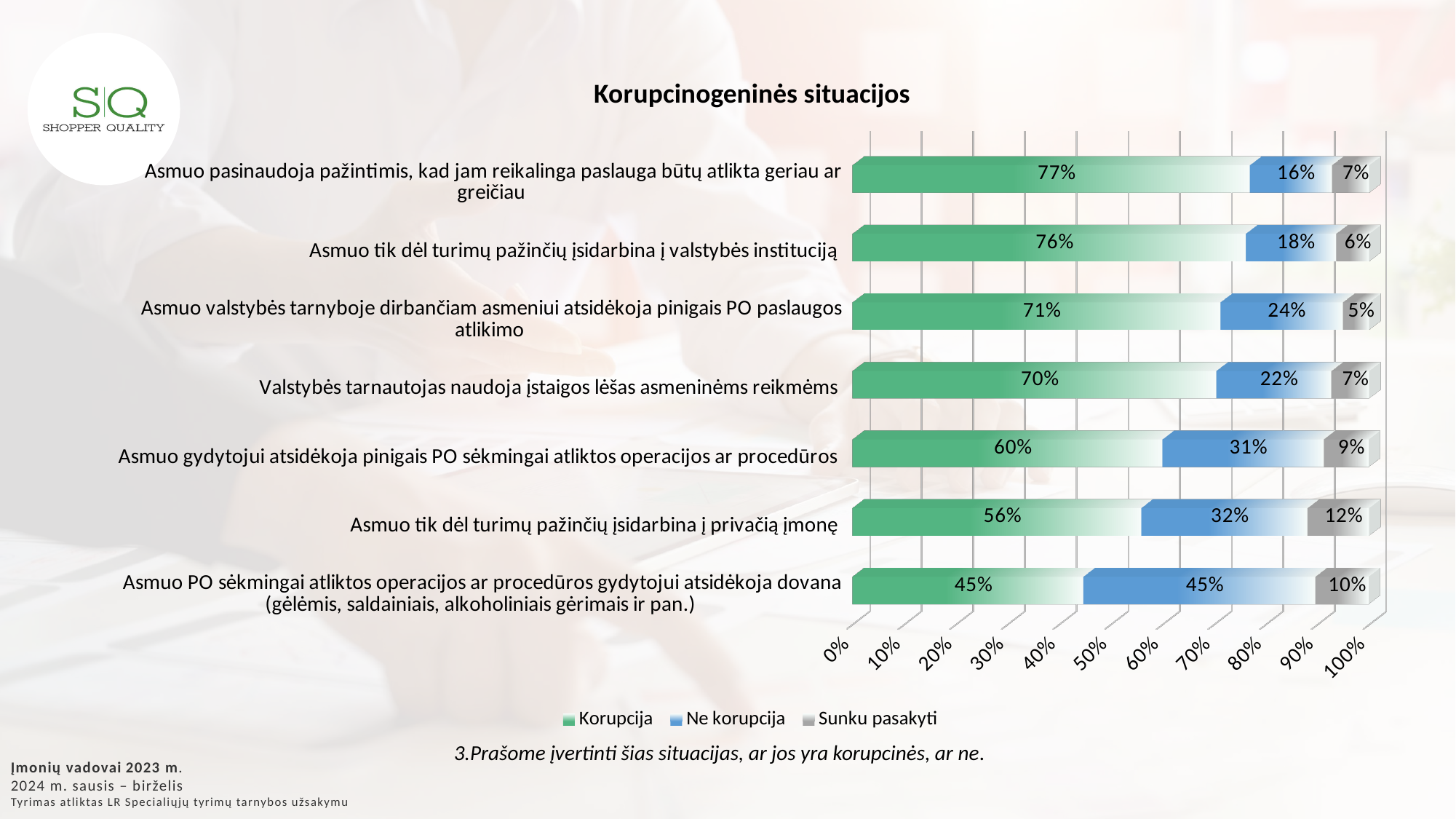
Which category has the highest 'Korupcija' value? Asmuo pasinaudoja pažintimis, kad jam reikalinga paslauga būtų atlikta geriau ar greičiau Which colour represents the 'Sunku pasakyti' series? Grey Which category has the lowest 'Korupcija' value? Asmuo PO sėkmingai atliktos operacijos ar procedūros gydytojui atsidėkoja dovana (gėlėmis, saldainiais, alkoholiniais gėrimais ir pan.) What is the title of the chart? Korupcinogeninės situacijos What is the 'Sunku pasakyti' value for 'Asmuo tik dėl turimų pažinčių įsidarbina į privačią įmonę'? 12% What is the 'Korupcija' value for 'Asmuo tik dėl turimų pažinčių įsidarbina į valstybės instituciją'? 76% Which is larger: the 'Ne korupcija' value for 'Asmuo valstybės tarnyboje dirbančiam asmeniui atsidėkoja pinigais PO paslaugos atlikimo' or for 'Asmuo tik dėl turimų pažinčių įsidarbina į privačią įmonę'? Asmuo tik dėl turimų pažinčių įsidarbina į privačią įmonę What is the difference between the 'Korupcija' and 'Ne korupcija' values for 'Valstybės tarnautojas naudoja įstaigos lėšas asmeninėms reikmėms'? 48% How many series does the legend list? 3 What type of chart is shown on the slide? Stacked bar chart What is the 'Ne korupcija' value for 'Asmuo gydytojui atsidėkoja pinigais PO sėkmingai atliktos operacijos ar procedūros'? 31% How many categories (situations) are plotted in the chart? 7